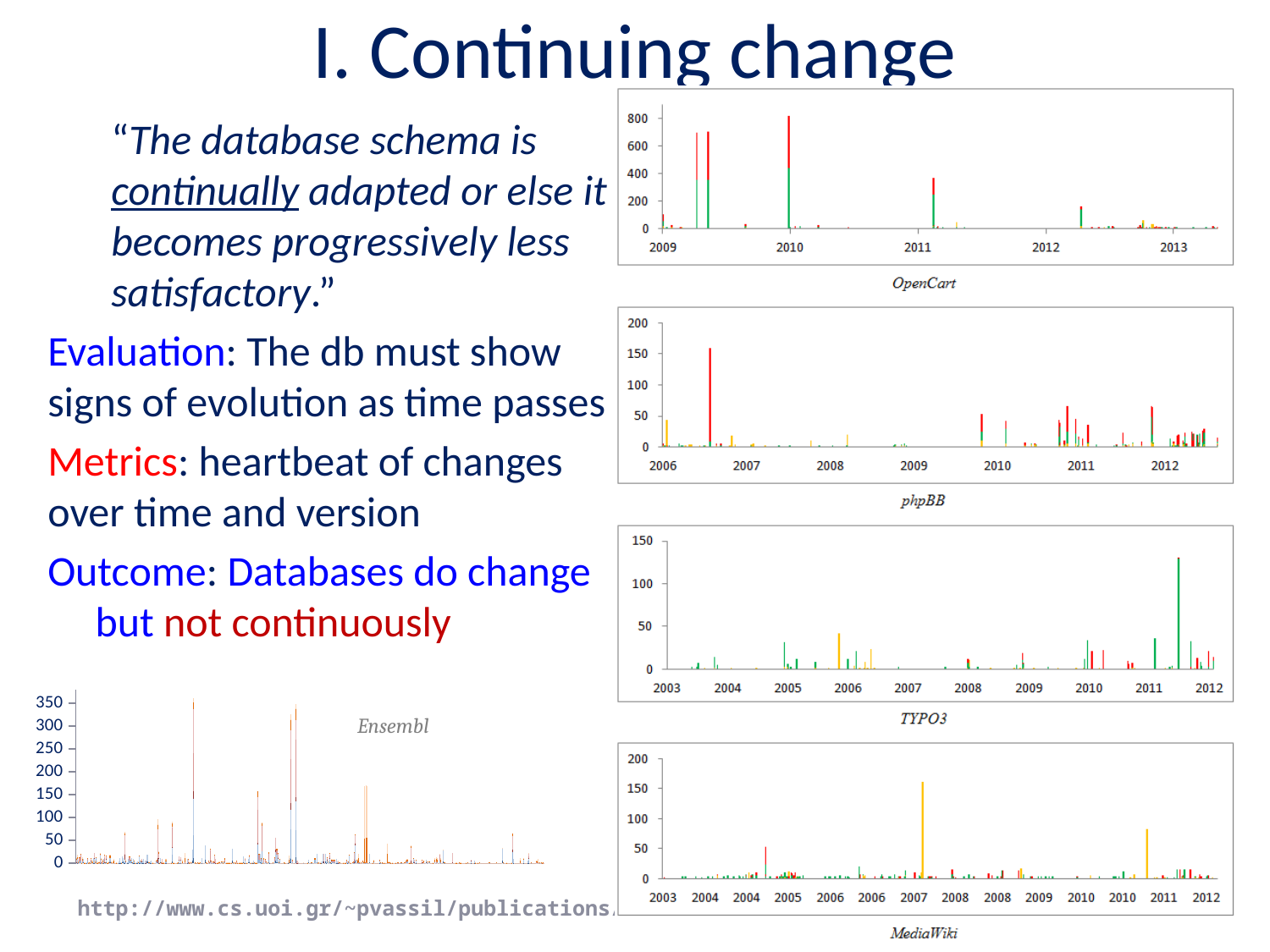
What kind of chart is the OpenCart chart? bar chart Which chart on the slide has a y-axis that goes up to 800? OpenCart In the TYPO3 chart, is the tallest bar greater or less than 100? greater In the Ensembl chart, is the tallest bar greater or less than 300? greater In the MediaWiki chart, is the tallest bar greater or less than 100? greater How many charts are shown on the slide? 5 What is the title of the chart in the bottom-left of the slide? Ensembl In the OpenCart chart, which is taller: the spike at the start of 2010 or the spike in early 2011? the spike at the start of 2010 In the TYPO3 chart, what is the first year shown on the x-axis? 2003